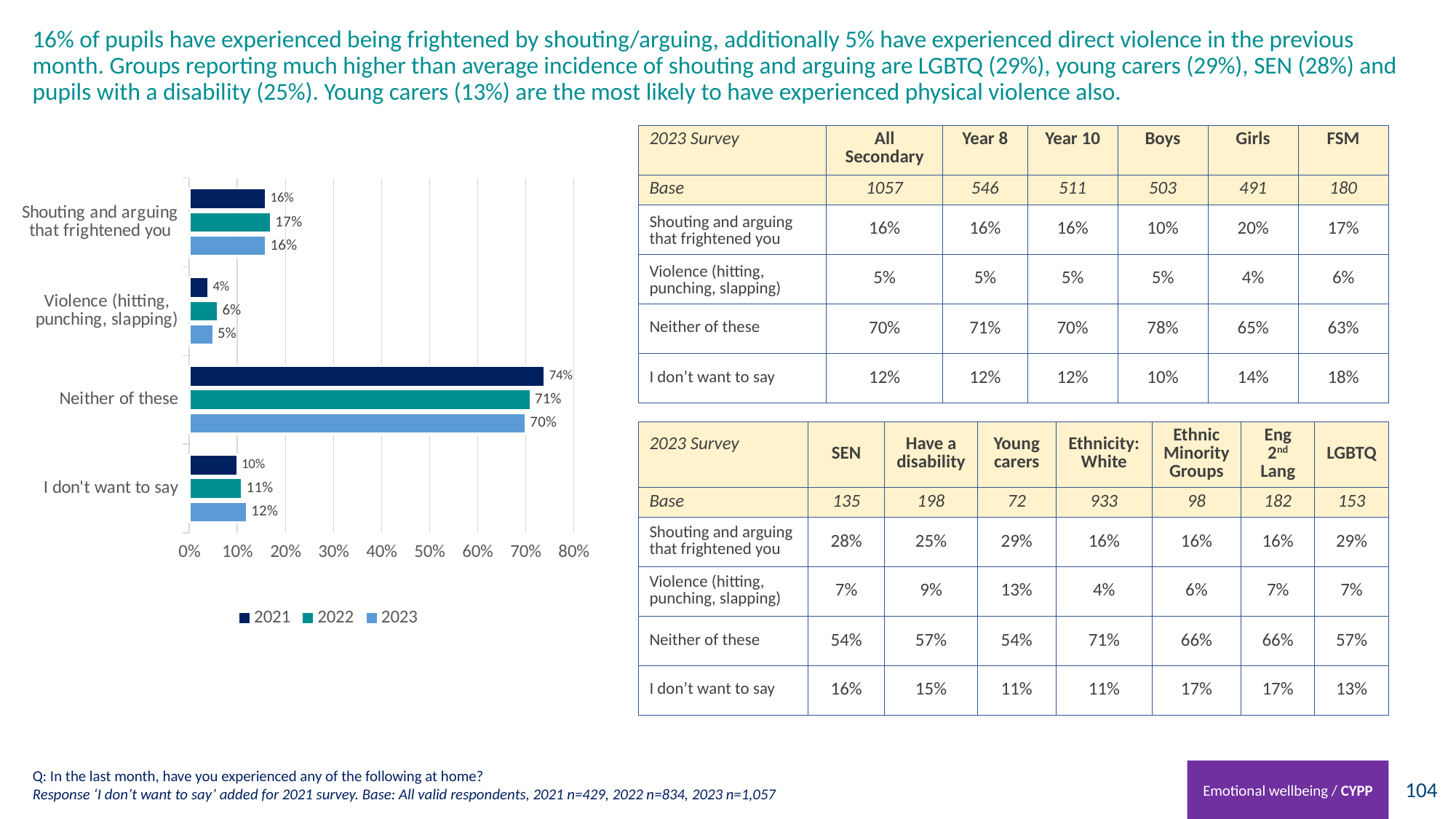
How many series does the legend of the bar chart list? 3 Which years are listed in the legend of the bar chart? 2021, 2022, 2023 What is the 2022 value for 'Shouting and arguing that frightened you' in the bar chart? 17% What is the 2021 value for 'Violence (hitting, punching, slapping)' in the bar chart? 4% What is the difference between the 2021 and 2023 values for 'Neither of these' in the bar chart? 4% Which category has the lowest value for 2023 in the bar chart? Violence (hitting, punching, slapping) In the bar chart, is the 2021 value for 'I don't want to say' larger or smaller than the 2023 value? smaller How many categories are shown in the bar chart? 4 Is the 2022 value for 'Neither of these' in the bar chart greater or less than 60%? greater What is the 2023 value for 'Neither of these' in the bar chart? 70% Which category has the highest value for 2021 in the bar chart? Neither of these What kind of chart is shown on the slide? bar chart